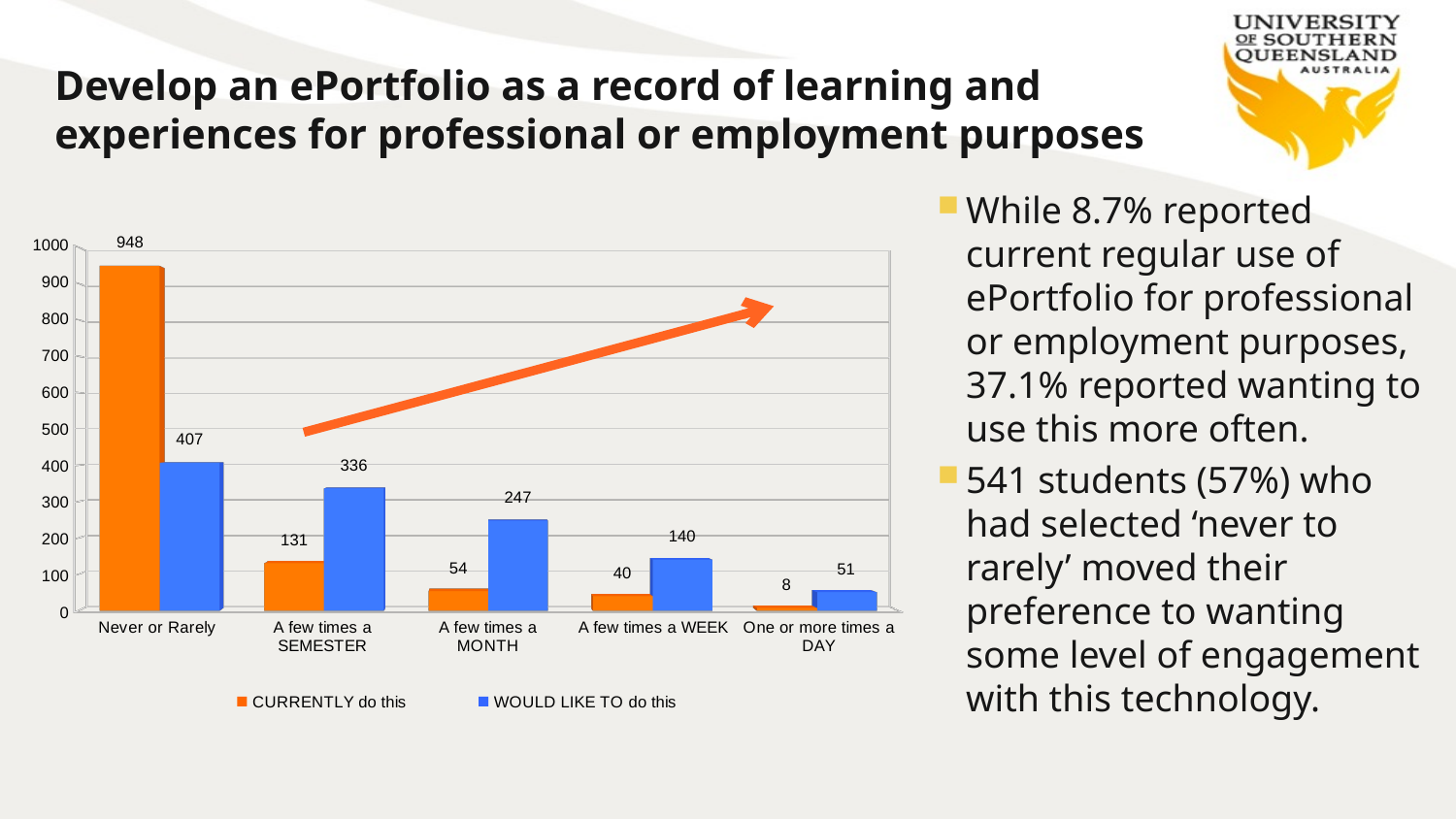
Which category has the lowest value for 'CURRENTLY do this'? One or more times a DAY What is the value for 'WOULD LIKE TO do this' in the 'A few times a MONTH' category? 247 How many series does the legend list? 2 Which category has the highest value for 'WOULD LIKE TO do this'? Never or Rarely What is the difference between 'WOULD LIKE TO do this' and 'CURRENTLY do this' in the 'A few times a SEMESTER' category? 205 What is the value for 'CURRENTLY do this' in the 'Never or Rarely' category? 948 What kind of chart is shown on the slide? Bar chart What is the difference between 'CURRENTLY do this' and 'WOULD LIKE TO do this' in the 'Never or Rarely' category? 541 What is the value for 'CURRENTLY do this' in the 'One or more times a DAY' category? 8 In the 'A few times a WEEK' category, which series has the larger value, 'CURRENTLY do this' or 'WOULD LIKE TO do this'? WOULD LIKE TO do this How many categories are shown on the x axis? 5 Do the values for 'CURRENTLY do this' rise or fall from left to right along the x axis? Fall